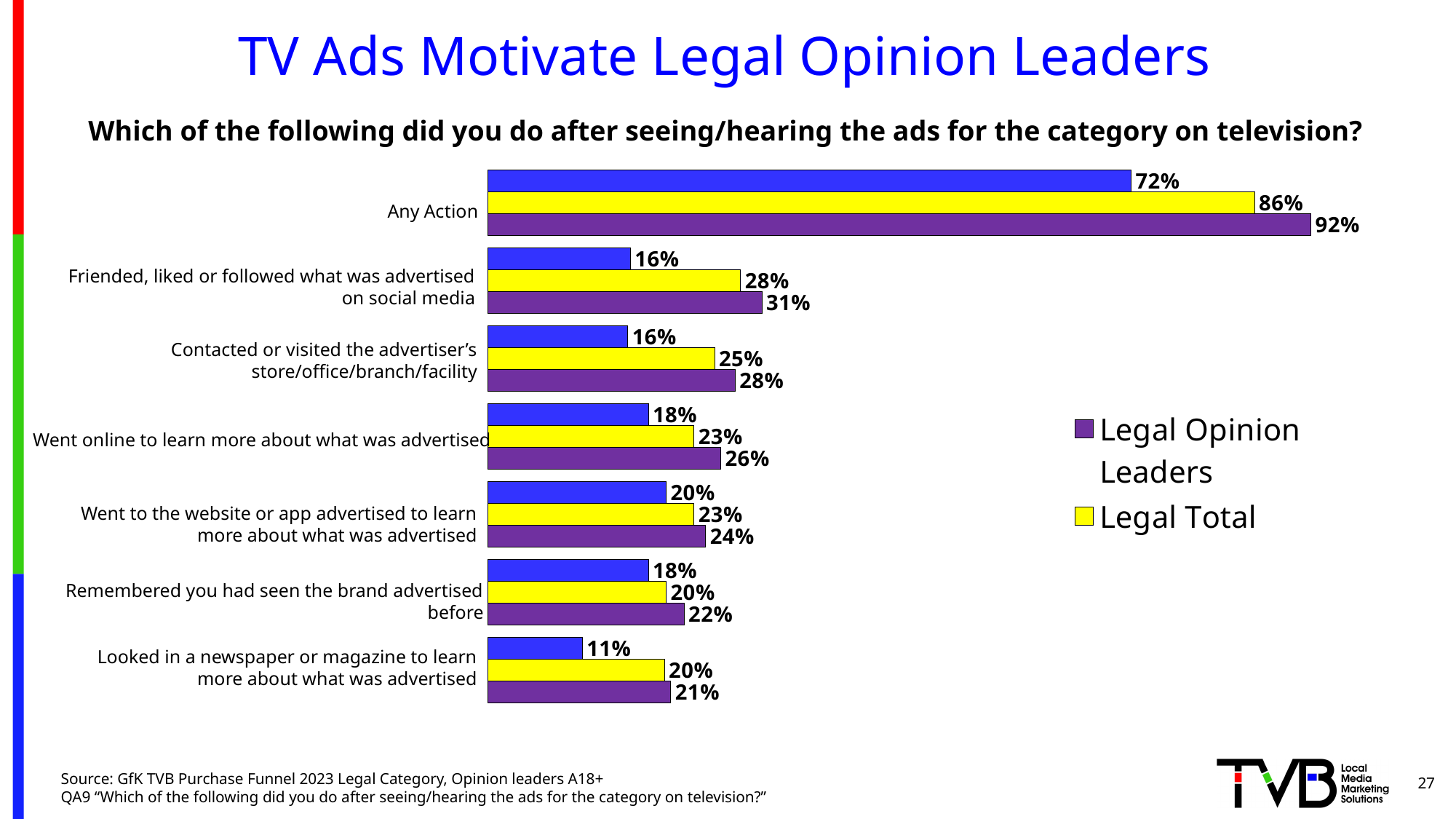
For 'Contacted or visited the advertiser's store/office/branch/facility', which is larger: the Legal Opinion Leaders value or the Legal Total value? Legal Opinion Leaders What percentage of Legal Opinion Leaders took Any Action after seeing the ads? 92% What is the difference between the Legal Opinion Leaders and Legal Total values for Any Action? 6 percentage points What is the Legal Opinion Leaders value for 'Looked in a newspaper or magazine to learn more about what was advertised'? 21% What is the Legal Total value for 'Friended, liked or followed what was advertised on social media'? 28% How many action categories are shown on the chart? 7 What type of chart is shown on the slide? Bar chart Excluding Any Action, which category has the lowest Legal Total value? Looked in a newspaper or magazine to learn more about what was advertised (tied with Remembered you had seen the brand advertised before) What colour represents Legal Total in the chart? Yellow How many series does the legend list? 2 What is the Legal Total value for 'Remembered you had seen the brand advertised before'? 20% Which category has the highest Legal Opinion Leaders value? Any Action